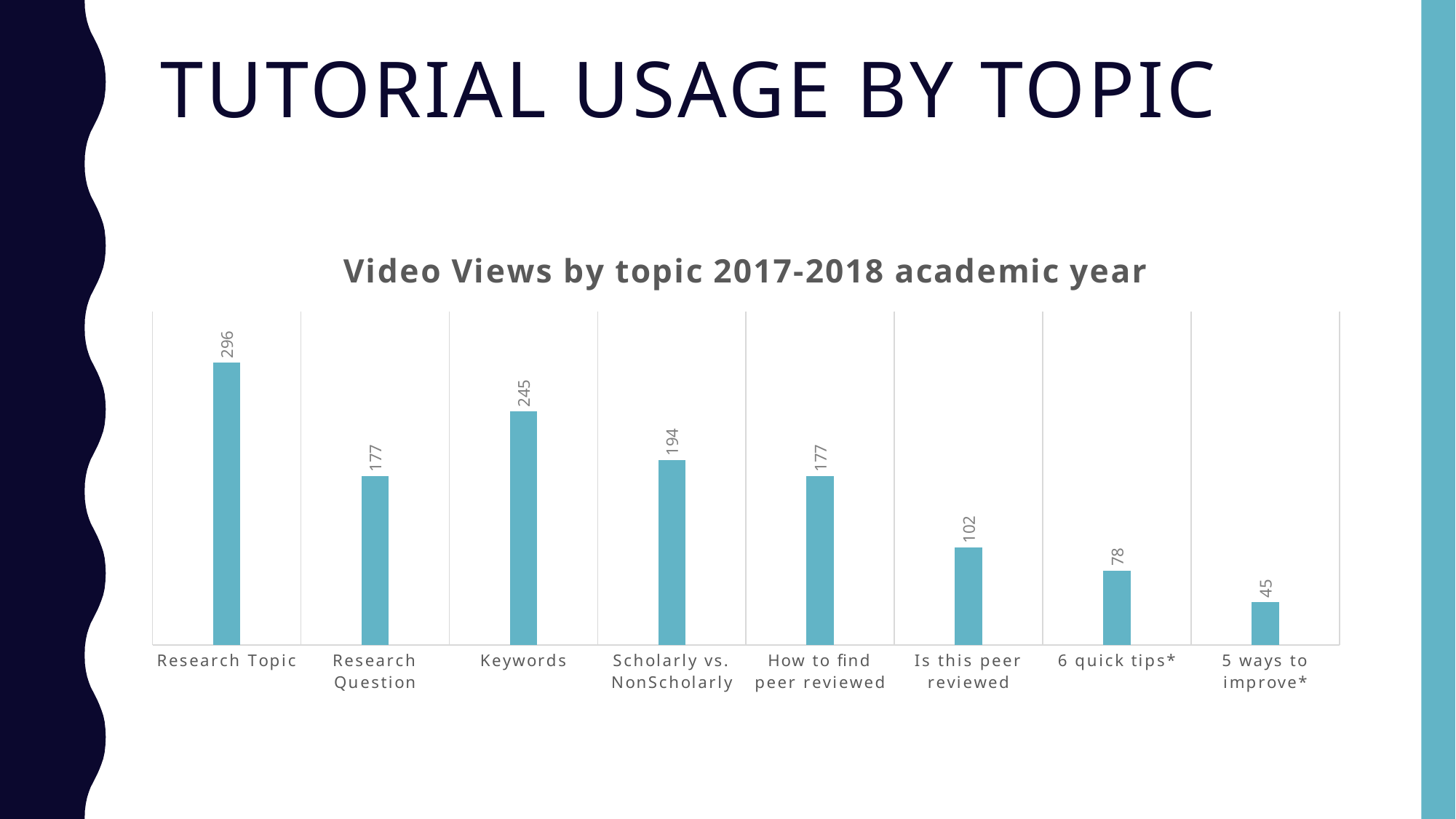
What is the difference between the values for Scholarly vs. NonScholarly and 6 quick tips*? 116 Which is larger, the value for Keywords or the value for Scholarly vs. NonScholarly? Keywords What kind of chart is shown on the slide? Bar chart What is the title of the chart? Video Views by topic 2017-2018 academic year What is the difference between the values for Research Topic and Keywords? 51 What is the value for Research Topic? 296 Which topic has the highest number of video views? Research Topic What is the value for Is this peer reviewed? 102 What is the value for 5 ways to improve*? 45 How many topics are shown on the chart? 8 What is the value for Keywords? 245 Which topic has the lowest number of video views? 5 ways to improve*